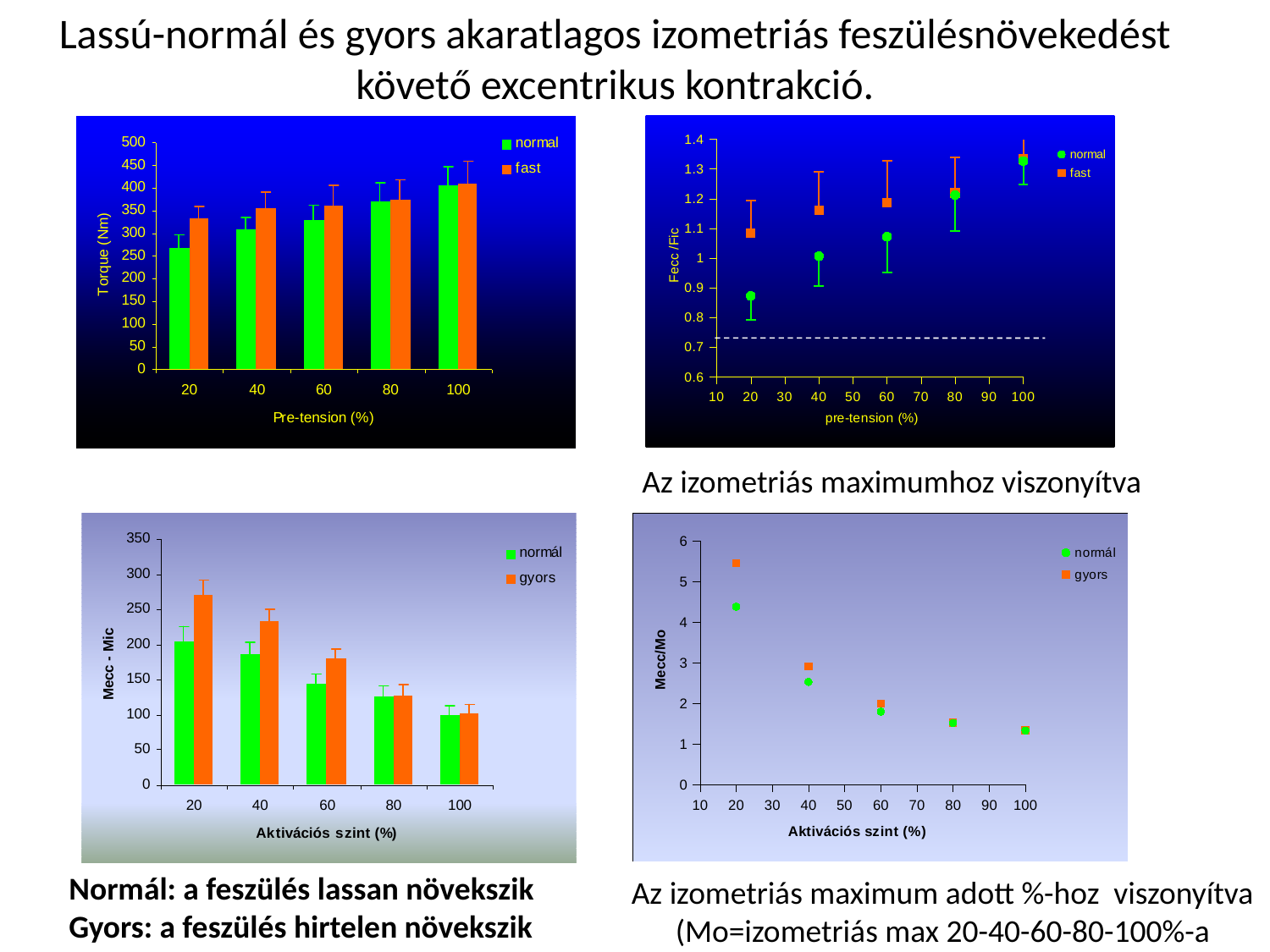
In the top-left chart (Torque vs Pre-tension), how many series does the legend list? 2 In the top-left chart (Torque vs Pre-tension), at 20% pre-tension, which series has the larger torque, normal or fast? fast In the top-right chart (Fecc/Fic vs pre-tension), is the normal value at 20% pre-tension greater or less than 1? less What kind of chart is the top-left chart (Torque vs Pre-tension)? bar chart In the top-left chart (Torque vs Pre-tension), is the normal torque at 20% pre-tension greater or less than 300? less In the top-left chart (Torque vs Pre-tension), does the torque for the normal series rise or fall as pre-tension increases? rise In the top-left chart (Torque vs Pre-tension), how many pre-tension categories are shown on the x axis? 5 In the bottom-right chart (Mecc/Mo vs Aktivációs szint), is the gyors value at 20% activation greater or less than 5? greater In the bottom-left chart (Mecc - Mic vs Aktivációs szint), at which activation level is the gyors series highest? 20 In the top-right chart (Fecc/Fic vs pre-tension), does the normal series rise or fall as pre-tension increases? rise In the bottom-left chart (Mecc - Mic vs Aktivációs szint), do the values rise or fall as the activation level increases? fall